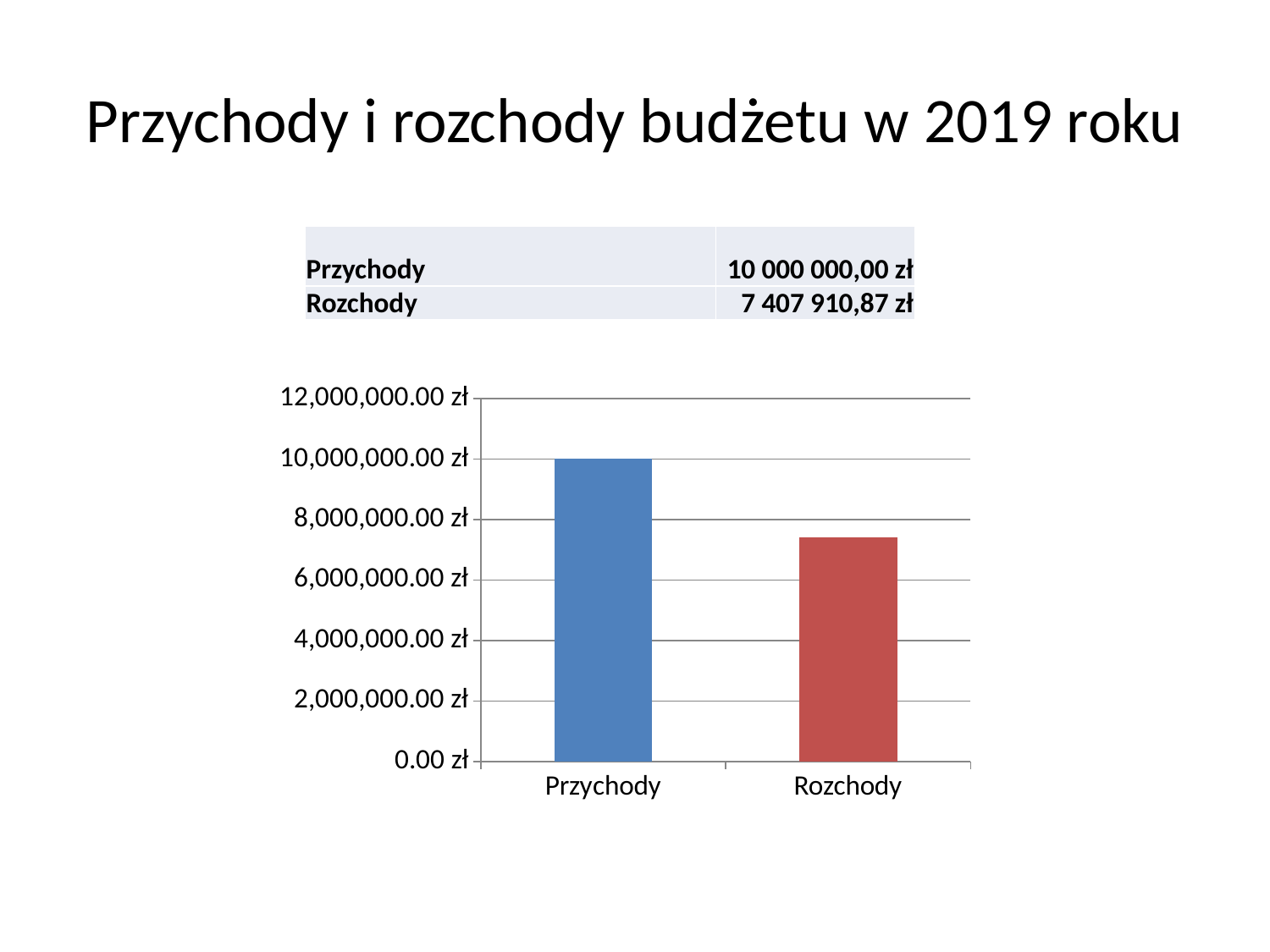
What is the highest value shown on the vertical axis of the chart? 12,000,000.00 zł Is the value for Rozchody greater or less than 8,000,000.00 zł? less Is the value for Przychody greater or less than 8,000,000.00 zł? greater What colour is the bar for Rozchody? red What is the difference between the Przychody and Rozchody values shown in the table? 2 592 089,13 zł Which category has the highest value in the chart? Przychody What type of chart is shown on the slide? bar chart How many categories are plotted in the chart? 2 What is the value for Przychody as shown in the table on the slide? 10 000 000,00 zł Which category has the lowest value in the chart? Rozchody What is the value for Rozchody as shown in the table on the slide? 7 407 910,87 zł Which category has the higher value, Przychody or Rozchody? Przychody